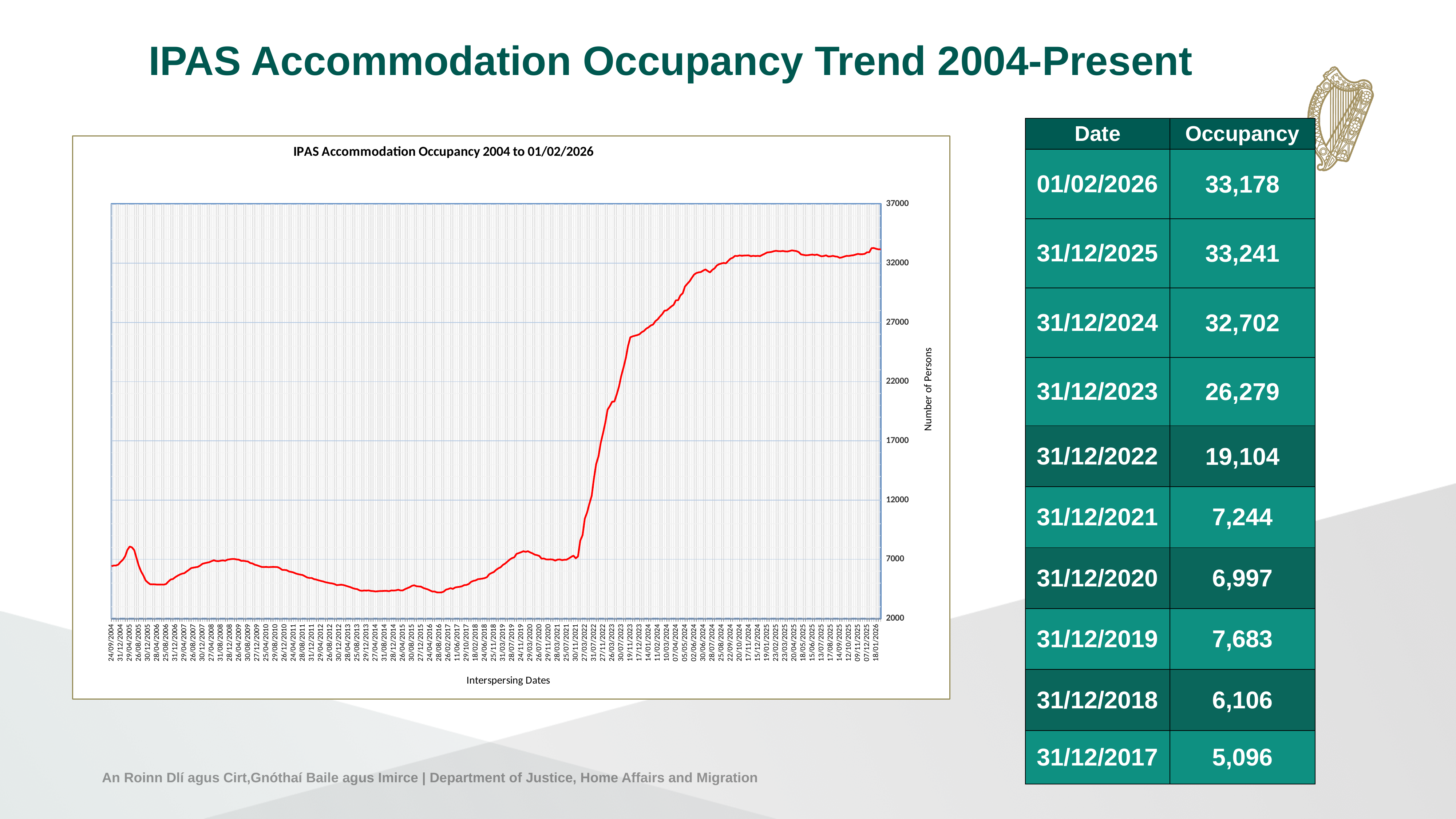
What is the title of the chart? IPAS Accommodation Occupancy 2004 to 01/02/2026 What kind of chart is shown on the slide? line chart Is the value for 31/12/2025 greater or less than 32000? greater What is the highest value shown on the chart's vertical axis? 37000 Is the value for 31/12/2022 greater or less than 17000? greater What is the lowest value shown on the chart's vertical axis? 2000 Does the line rise or fall between 31/08/2008 and 28/08/2016? fall What is the label on the vertical axis of the chart? Number of Persons Is the value for 31/12/2020 greater or less than 12000? less Does the line rise or fall between 30/11/2021 and 30/06/2024? rise Which of the two dates has the larger value on the chart, 31/12/2019 or 31/12/2023? 31/12/2023